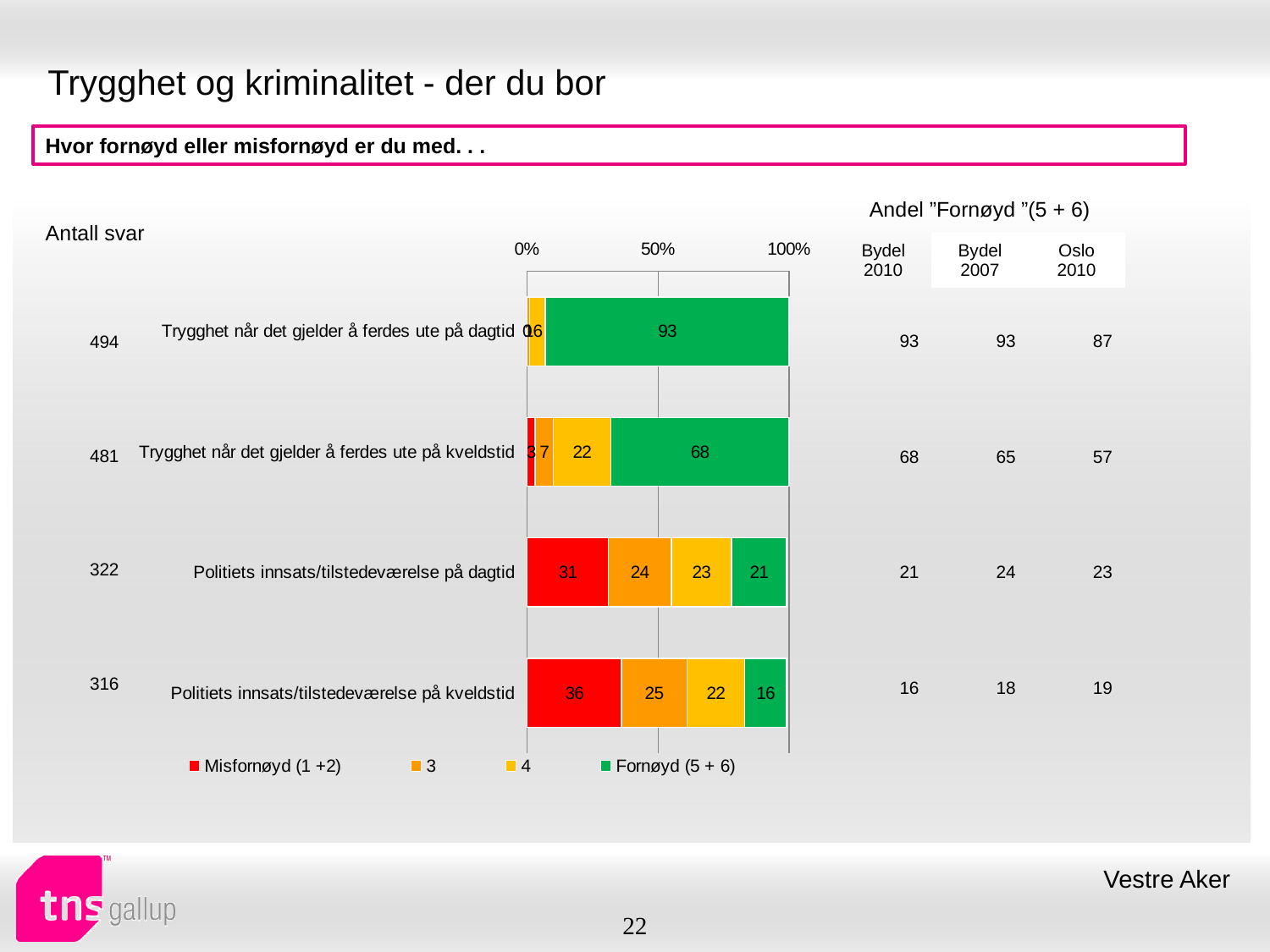
How many categories are plotted in the chart? 4 What is the 'Fornøyd (5 + 6)' value for 'Trygghet når det gjelder å ferdes ute på kveldstid'? 68 What colour represents the 'Fornøyd (5 + 6)' series in the chart? green Which category has the lowest 'Fornøyd (5 + 6)' value? Politiets innsats/tilstedeværelse på kveldstid Which is larger: the 'Fornøyd (5 + 6)' value for 'Politiets innsats/tilstedeværelse på dagtid' or for 'Politiets innsats/tilstedeværelse på kveldstid'? Politiets innsats/tilstedeværelse på dagtid What is the 'Fornøyd (5 + 6)' value for 'Trygghet når det gjelder å ferdes ute på dagtid'? 93 How many series does the chart legend list? 4 What kind of chart is shown on the slide? stacked bar chart What is the 'Misfornøyd (1 +2)' value for 'Politiets innsats/tilstedeværelse på kveldstid'? 36 What is the difference between the 'Misfornøyd (1 +2)' values for 'Politiets innsats/tilstedeværelse på kveldstid' and 'Politiets innsats/tilstedeværelse på dagtid'? 5 What is the value of series '4' for 'Politiets innsats/tilstedeværelse på dagtid'? 23 Which category has the highest 'Fornøyd (5 + 6)' value? Trygghet når det gjelder å ferdes ute på dagtid